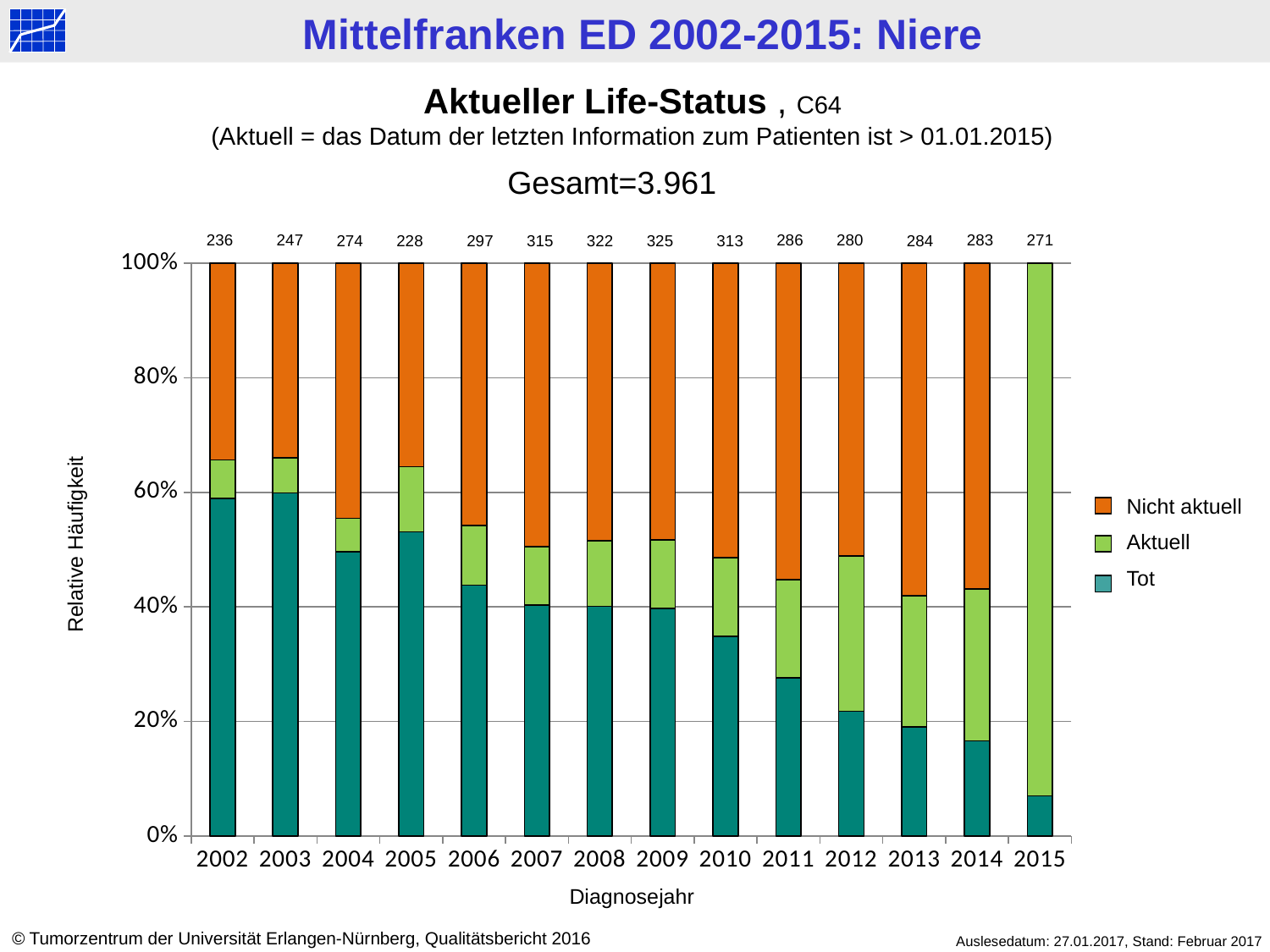
What kind of chart is shown on the slide? stacked bar chart What is the number printed above the bar for 2015? 271 How many series does the legend list? 3 What is the difference between the numbers printed above the bars for 2009 and 2005? 97 How many diagnosis years (Diagnosejahr) are shown on the x axis? 14 Does the share of 'Tot' generally rise or fall from 2002 to 2015? fall Which diagnosis year has the lowest number printed above its bar? 2005 Is the share of 'Tot' in 2015 greater or less than 20%? less What is the number printed above the bar for 2006? 297 Is the share of 'Tot' in 2002 greater or less than 40%? greater Which diagnosis year has the highest number printed above its bar? 2009 Which year has the larger number printed above its bar, 2007 or 2008? 2008